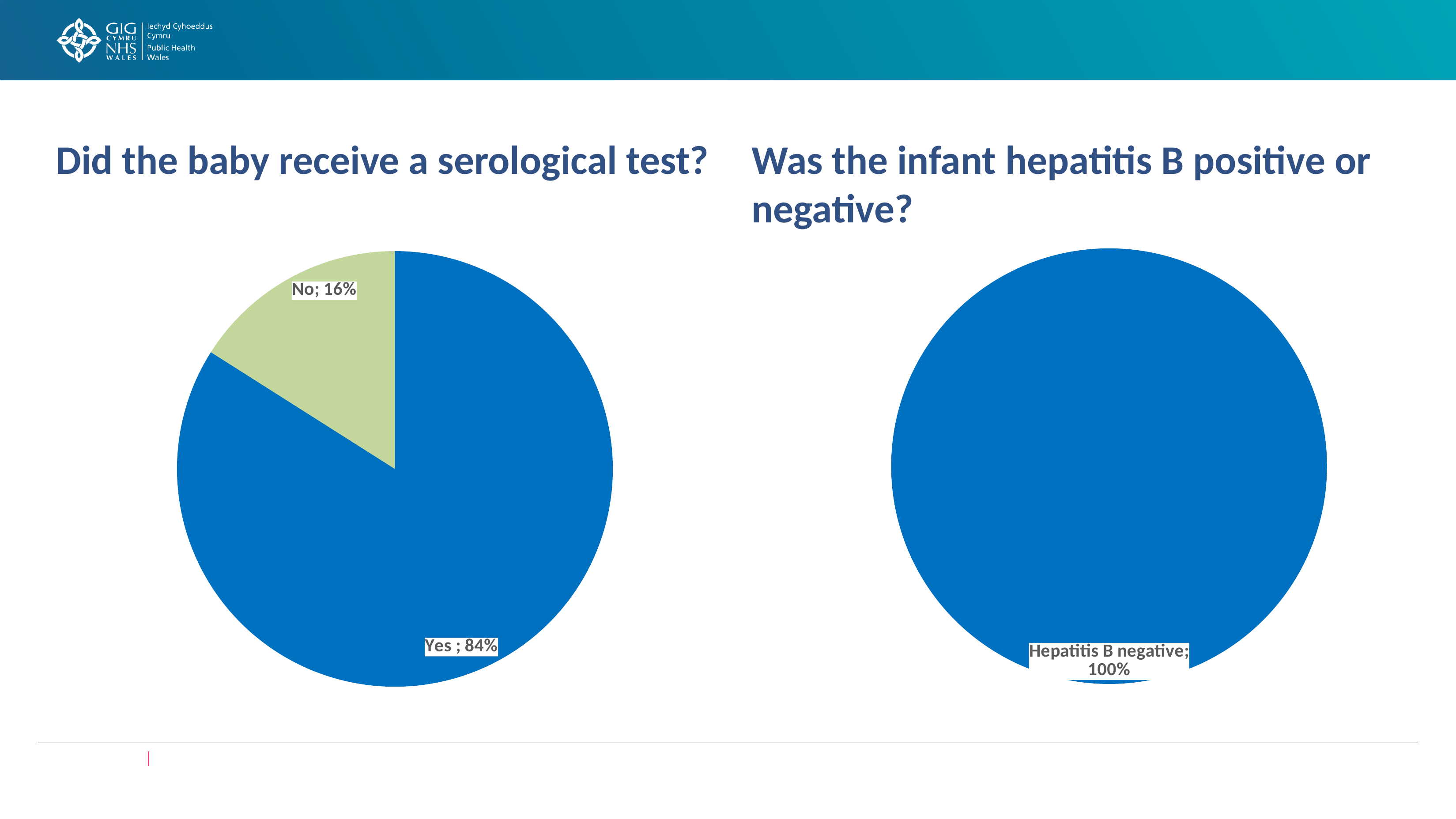
In the chart titled "Did the baby receive a serological test?", which is larger, the "Yes" slice or the "No" slice? Yes What kind of chart is the chart titled "Did the baby receive a serological test?"? Pie chart In the chart titled "Did the baby receive a serological test?", what share of the pie is labelled "No"? 16% In the chart titled "Did the baby receive a serological test?", what colour is the "No" slice? Green In the chart titled "Did the baby receive a serological test?", what share of the pie is labelled "Yes"? 84% In the chart titled "Did the baby receive a serological test?", which slice is the largest? Yes In the chart titled "Did the baby receive a serological test?", how many slices does the pie have? 2 In the chart titled "Did the baby receive a serological test?", what is the difference in percentage points between the "Yes" and "No" slices? 68 In the chart titled "Was the infant hepatitis B positive or negative?", how many slices does the pie have? 1 In the chart titled "Did the baby receive a serological test?", which slice is the smallest? No What kind of chart is the chart titled "Was the infant hepatitis B positive or negative?"? Pie chart In the chart titled "Was the infant hepatitis B positive or negative?", what share of the pie is labelled "Hepatitis B negative"? 100%